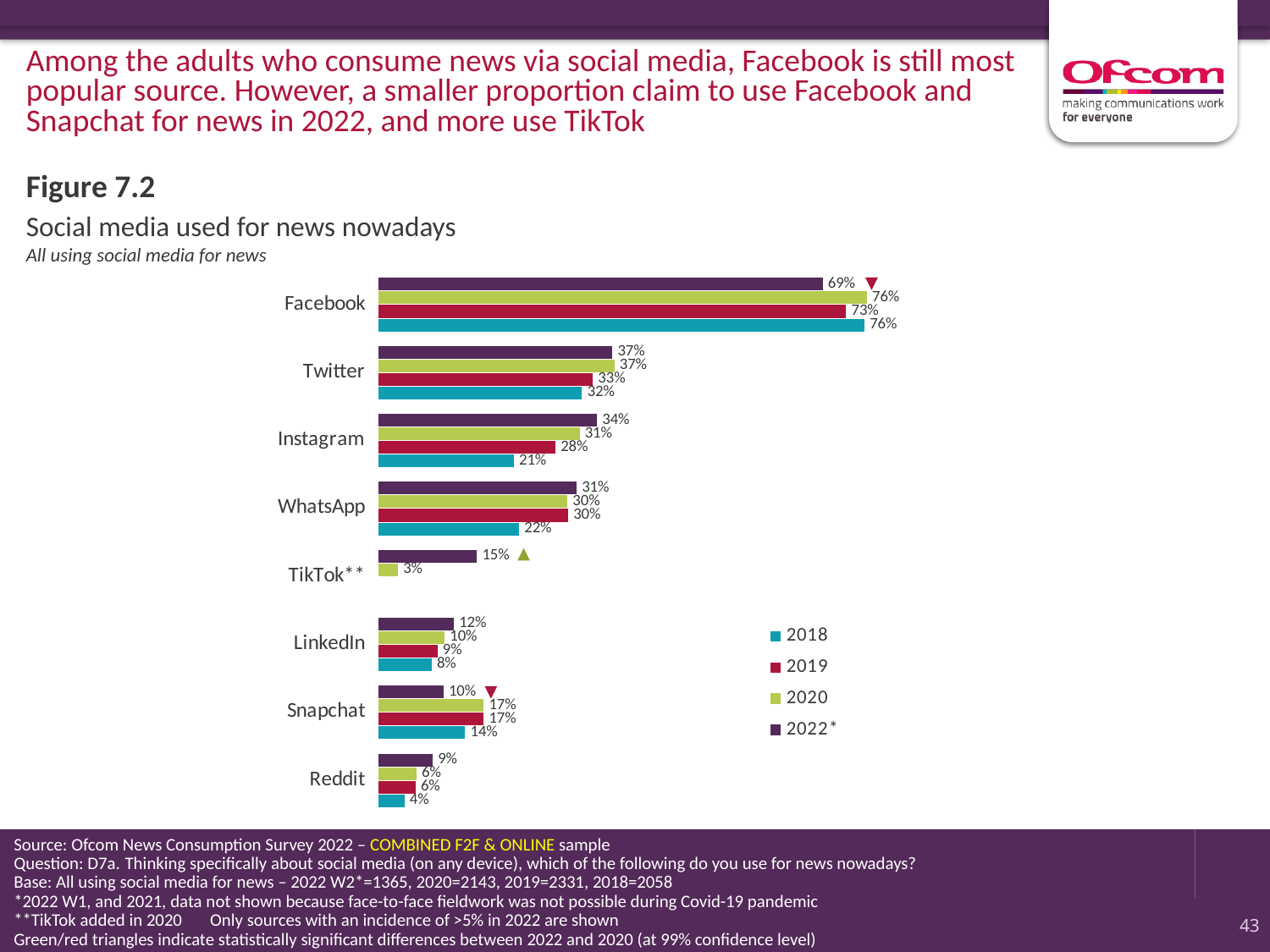
What is the difference between the 2020 and 2022* values for Snapchat? 7% What is the 2020 value for TikTok**? 3% What is the difference between the 2022* and 2020 values for TikTok**? 12% How many series does the legend list? 4 Which platform has the lowest 2018 value? Reddit What is the 2018 value for Instagram? 21% Which series is shown in purple in the legend? 2022* What is the 2022* value for Facebook? 69% What type of chart is shown on the slide? bar chart Which platform has the highest 2022* value? Facebook Which is larger for WhatsApp: the 2022* value or the 2018 value? 2022* How many social media platforms are shown as categories in the chart? 8